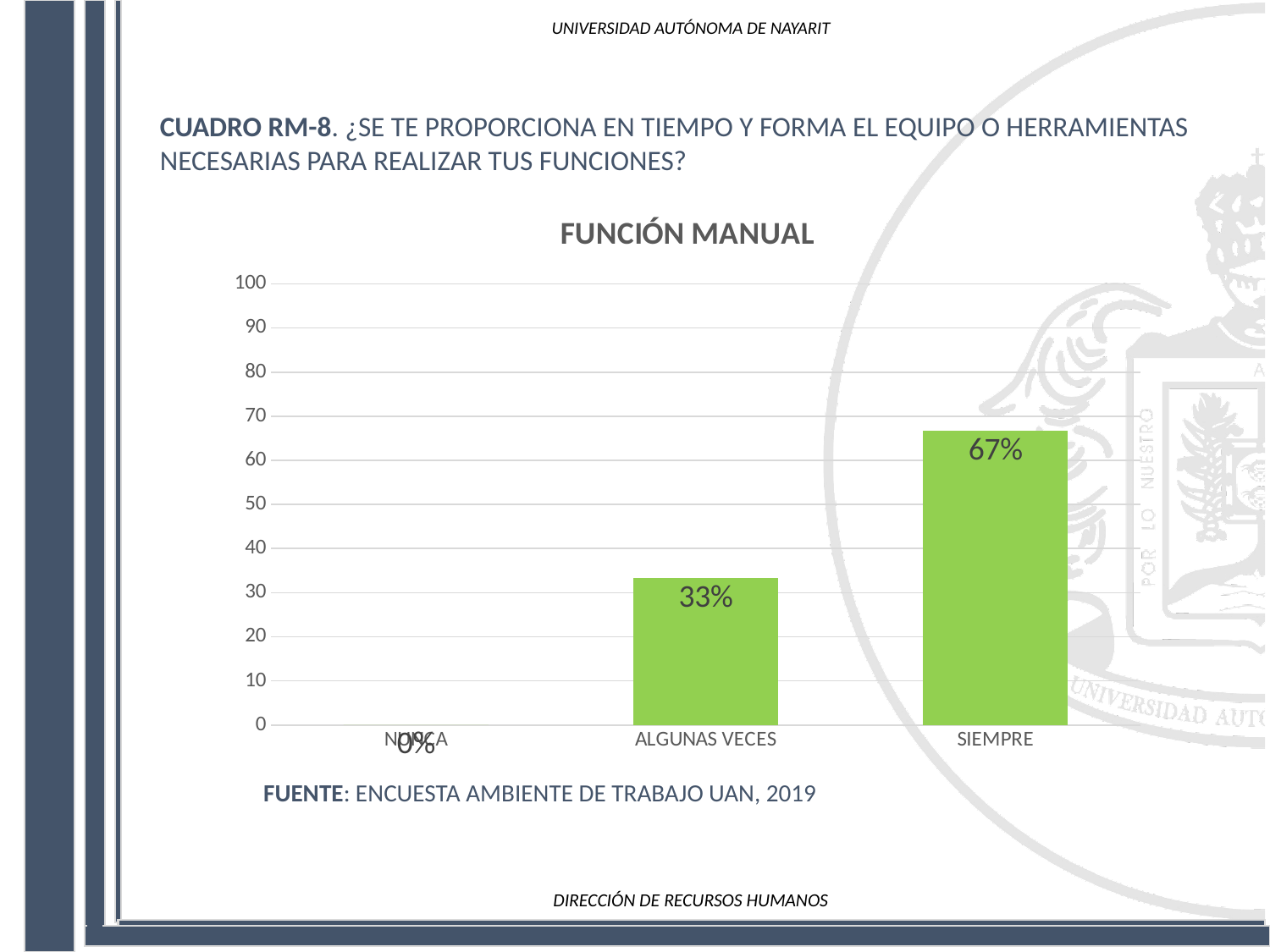
What is the title of the chart? FUNCIÓN MANUAL Is the value for SIEMPRE greater or less than 60? greater What is the difference between the values for SIEMPRE and ALGUNAS VECES? 34% What is the value for SIEMPRE? 67% What is the value for ALGUNAS VECES? 33% What is the value for NUNCA? 0% What kind of chart is shown? bar chart How many categories are shown on the x axis? 3 Which is larger, the value for ALGUNAS VECES or the value for SIEMPRE? SIEMPRE Which category has the lowest value? NUNCA Which category has the highest value? SIEMPRE Do the values rise or fall from NUNCA to SIEMPRE along the x axis? rise